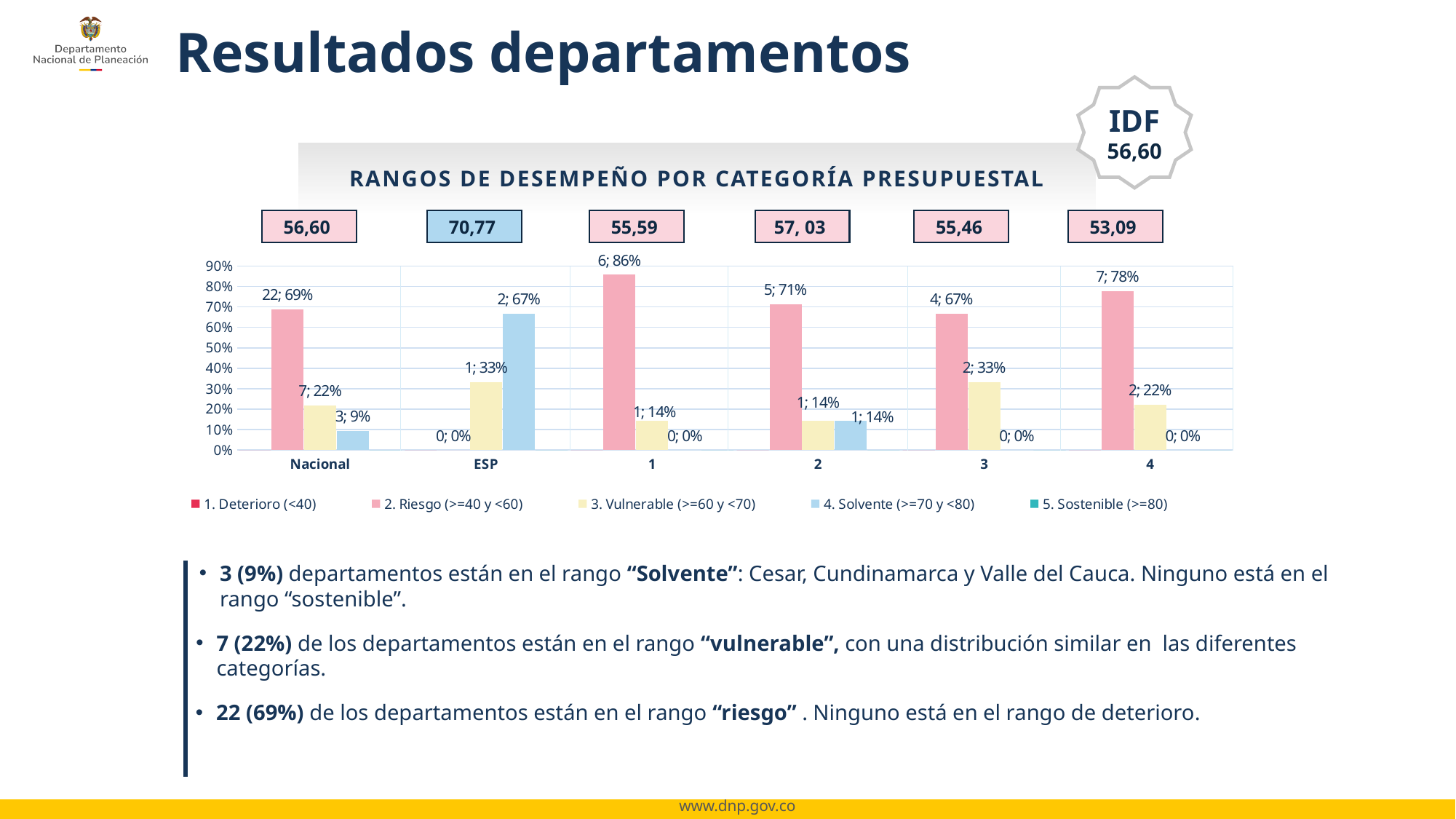
What is the data label for the "2. Riesgo" bar in the Nacional category? 22; 69% What is the difference in percentage points between the "2. Riesgo" value for category 1 and for category 2? 15 percentage points What kind of chart is shown under the title "RANGOS DE DESEMPEÑO POR CATEGORÍA PRESUPUESTAL"? Bar chart What is the data label for the "2. Riesgo" bar in category 4? 7; 78% In the Nacional category, which is larger: the "2. Riesgo" percentage or the "3. Vulnerable" percentage? 2. Riesgo What is the data label for the "4. Solvente" bar in the ESP category? 2; 67% How many categories are shown along the x axis of the chart? 6 What is the data label for the "3. Vulnerable" bar in category 3? 2; 33% How many series does the legend of the chart list? 5 Which category has the lowest percentage for "2. Riesgo"? ESP What range does the legend give for the "4. Solvente" series? >=70 y <80 Which category has the highest percentage for "2. Riesgo"? 1